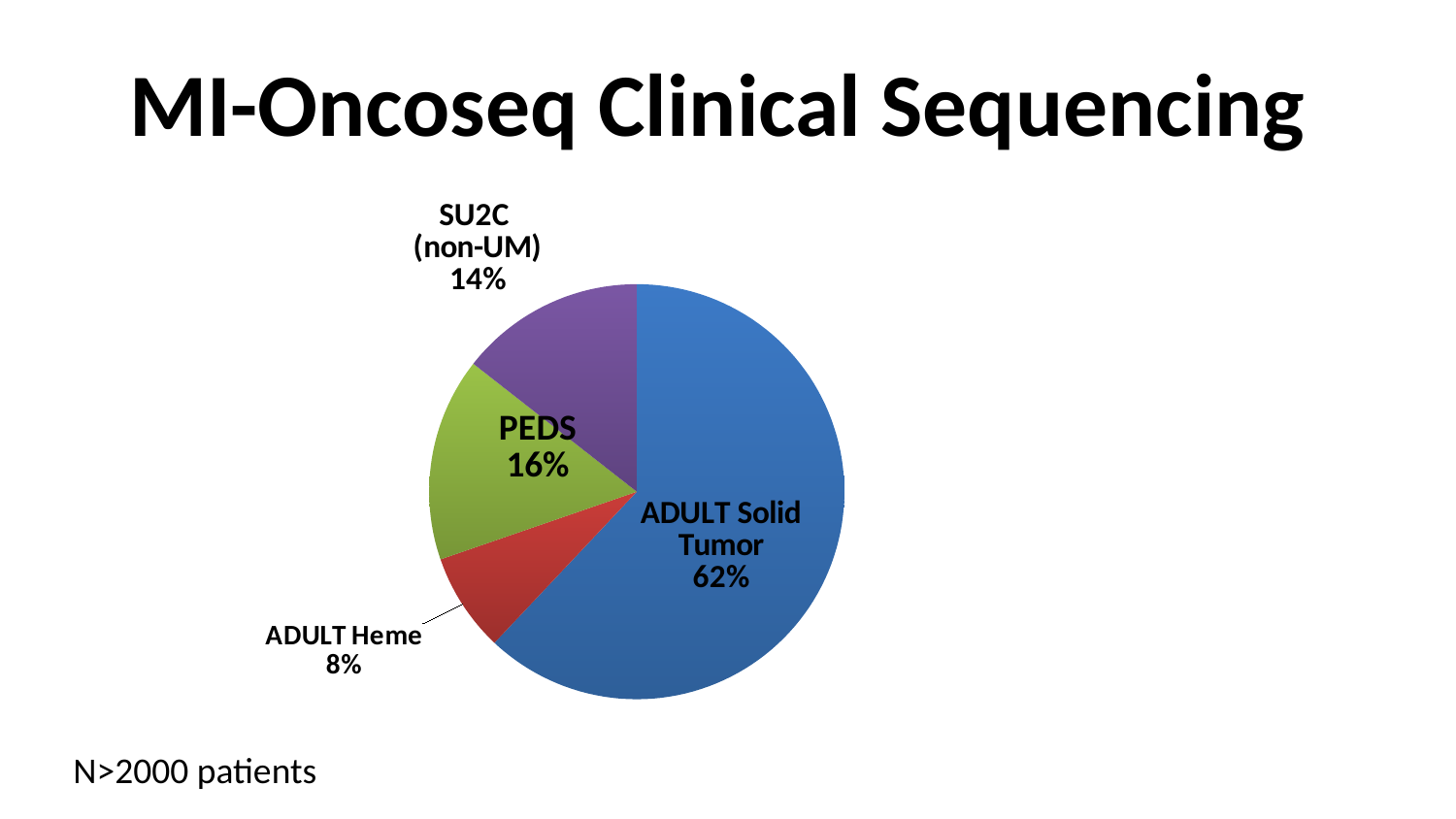
Which category has the largest slice of the pie? ADULT Solid Tumor Which is larger, the PEDS slice or the SU2C (non-UM) slice? PEDS What percentage is shown for ADULT Heme? 8% Which category has the smallest slice of the pie? ADULT Heme What is the title of the slide containing the pie chart? MI-Oncoseq Clinical Sequencing What is the difference in percentage points between ADULT Solid Tumor and PEDS? 46 What percentage is shown for SU2C (non-UM)? 14% What kind of chart is shown on the slide? Pie chart What percentage is shown for PEDS? 16% How many slices does the pie chart have? 4 What is the difference in percentage points between PEDS and ADULT Heme? 8 What share of the pie does ADULT Solid Tumor represent? 62%